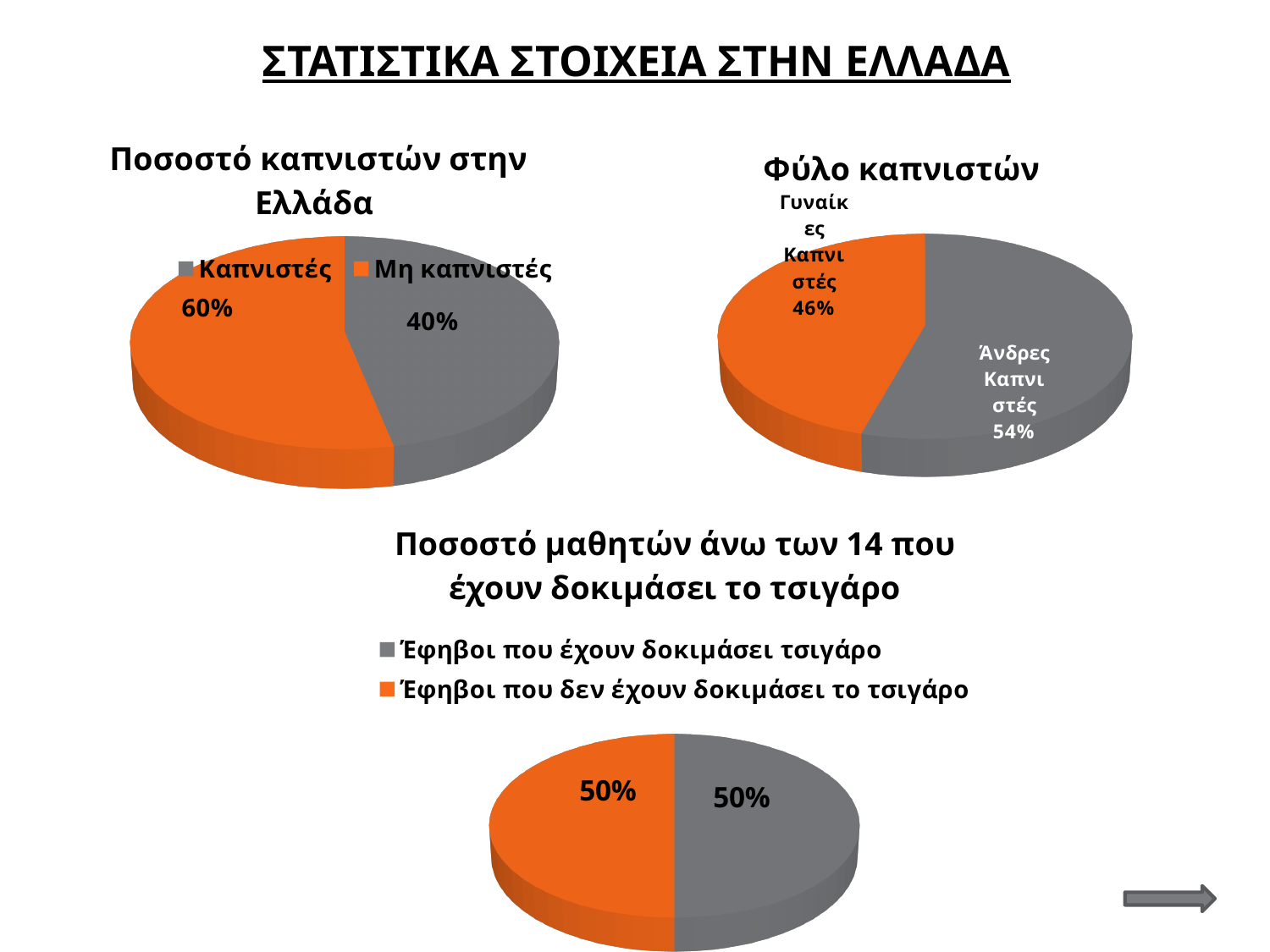
In the chart titled 'Ποσοστό καπνιστών στην Ελλάδα', what percentage is shown for 'Καπνιστές'? 40% How many slices does the chart titled 'Ποσοστό μαθητών άνω των 14 που έχουν δοκιμάσει το τσιγάρο' have? 2 In the chart titled 'Ποσοστό καπνιστών στην Ελλάδα', what percentage is shown for 'Μη καπνιστές'? 60% In the chart titled 'Φύλο καπνιστών', what percentage is shown for 'Άνδρες Καπνιστές'? 54% In the chart titled 'Ποσοστό καπνιστών στην Ελλάδα', what is the difference between the 'Μη καπνιστές' and 'Καπνιστές' shares? 20% What kind of chart is the chart titled 'Φύλο καπνιστών'? Pie chart In the chart titled 'Ποσοστό μαθητών άνω των 14 που έχουν δοκιμάσει το τσιγάρο', what percentage is shown for 'Έφηβοι που έχουν δοκιμάσει τσιγάρο'? 50% In the chart titled 'Φύλο καπνιστών', what percentage is shown for 'Γυναίκες Καπνιστές'? 46% In the chart titled 'Ποσοστό καπνιστών στην Ελλάδα', which category has the larger share? Μη καπνιστές In the chart titled 'Φύλο καπνιστών', what is the difference between the 'Άνδρες Καπνιστές' and 'Γυναίκες Καπνιστές' shares? 8% How many entries does the legend of the chart titled 'Ποσοστό καπνιστών στην Ελλάδα' list? 2 In the chart titled 'Φύλο καπνιστών', which category has the smaller share? Γυναίκες Καπνιστές